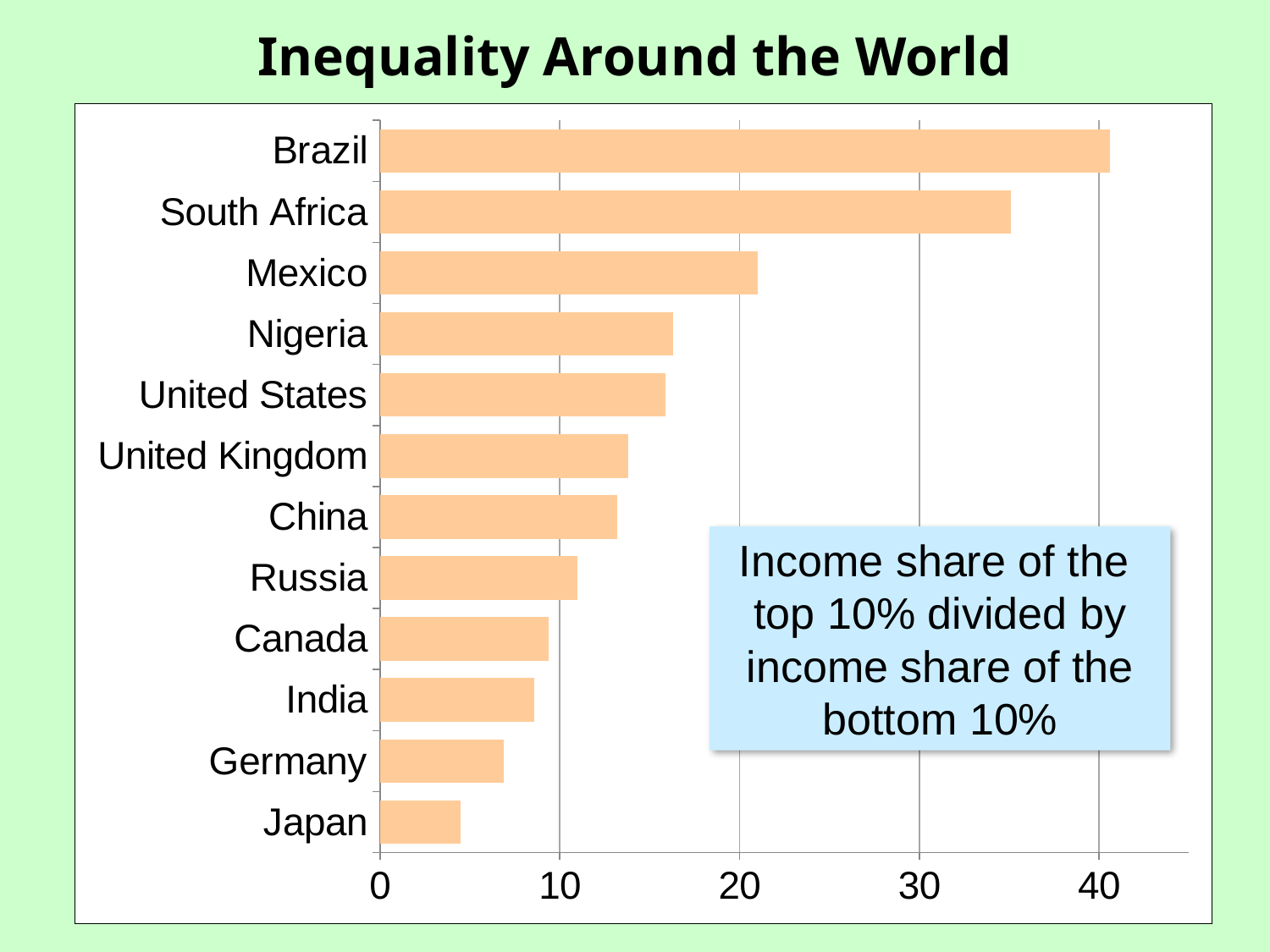
Is the value for Russia greater or less than 10? greater Is the value for South Africa greater or less than 30? greater Is the value for Nigeria greater or less than 20? less How many countries are shown in the chart? 12 Which has a larger value, Brazil or South Africa? Brazil Which has a larger value, Germany or Japan? Germany What is the title of the slide? Inequality Around the World What kind of chart is shown on the slide? Bar chart Which country has the lowest value in the chart? Japan Which country has the highest value in the chart? Brazil